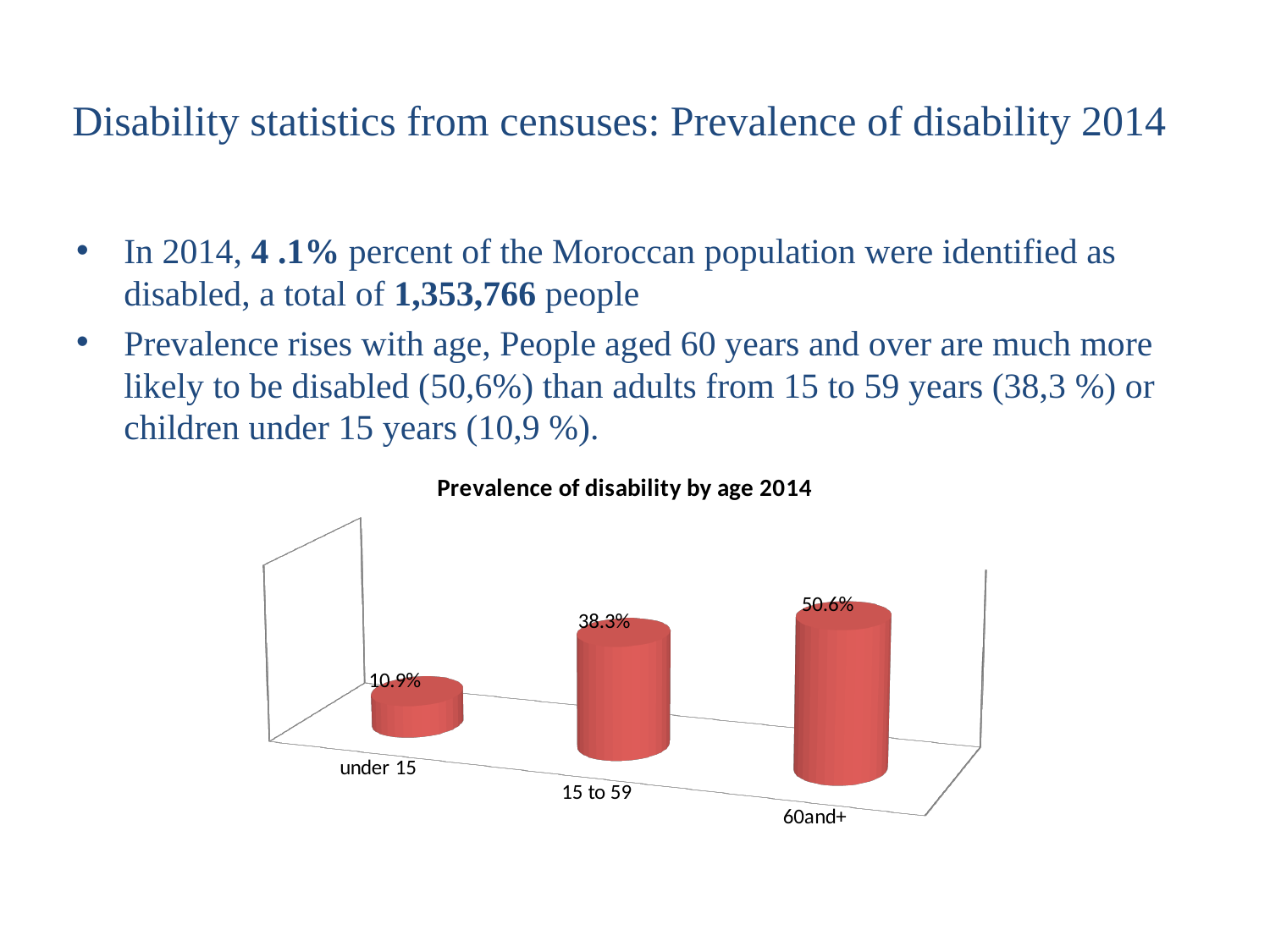
How many age groups are shown in the chart? 3 What kind of chart is shown on the slide? bar chart Do the values rise or fall as age increases along the x axis? rise Which age group has the lowest prevalence of disability in the chart? under 15 Which age group has the highest prevalence of disability in the chart? 60and+ What is the difference between the values for '60and+' and '15 to 59'? 12.3% What is the value for the '15 to 59' age group in the chart? 38.3% What is the value for the '60and+' age group in the chart? 50.6% What is the value for the 'under 15' age group in the chart? 10.9% Which is larger, the value for '15 to 59' or the value for 'under 15'? 15 to 59 What is the title of the chart? Prevalence of disability by age 2014 What is the difference between the values for '15 to 59' and 'under 15'? 27.4%